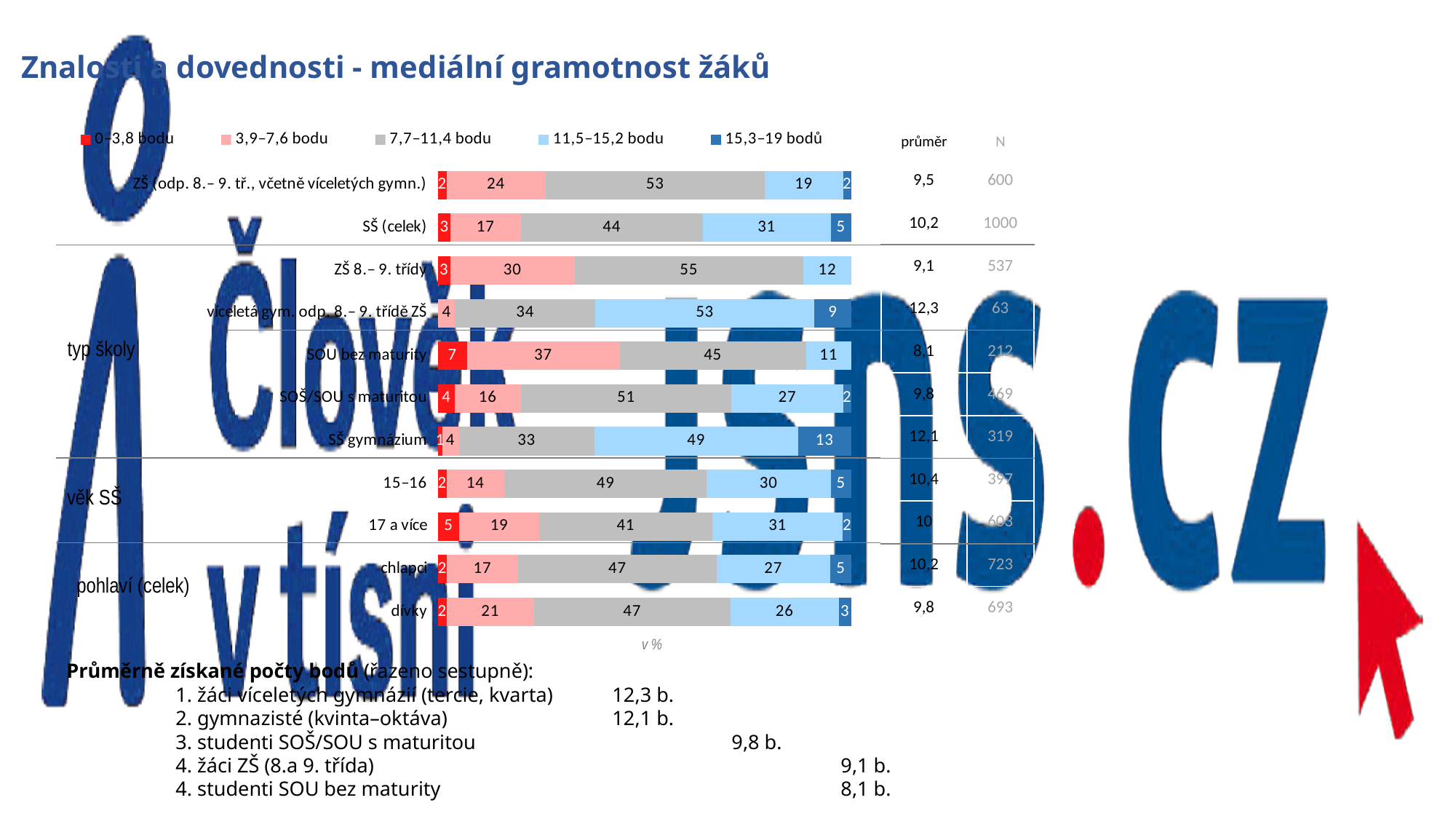
What is the průměr (average) shown for víceletá gym. odp. 8.–9. třídě ZŠ? 12,3 What is the value of the 7,7–11,4 bodu series for SŠ (celek)? 44 Which has a larger 3,9–7,6 bodu value, chlapci or dívky? dívky What is the value of the 3,9–7,6 bodu series for SOU bez maturity? 37 How many series does the legend list? 5 What kind of chart is shown on the slide? stacked bar chart What is the value of the 11,5–15,2 bodu series for SŠ gymnázium? 49 How many categories (bars) are plotted in the chart? 11 Which category has the lowest value in the 0–3,8 bodu series? SŠ gymnázium Which category has the highest value in the 7,7–11,4 bodu series? ZŠ 8.–9. třídy What is the total of the stacked bar for SŠ (celek)? 100 What is the difference between the 11,5–15,2 bodu values for 17 a více and 15–16? 1